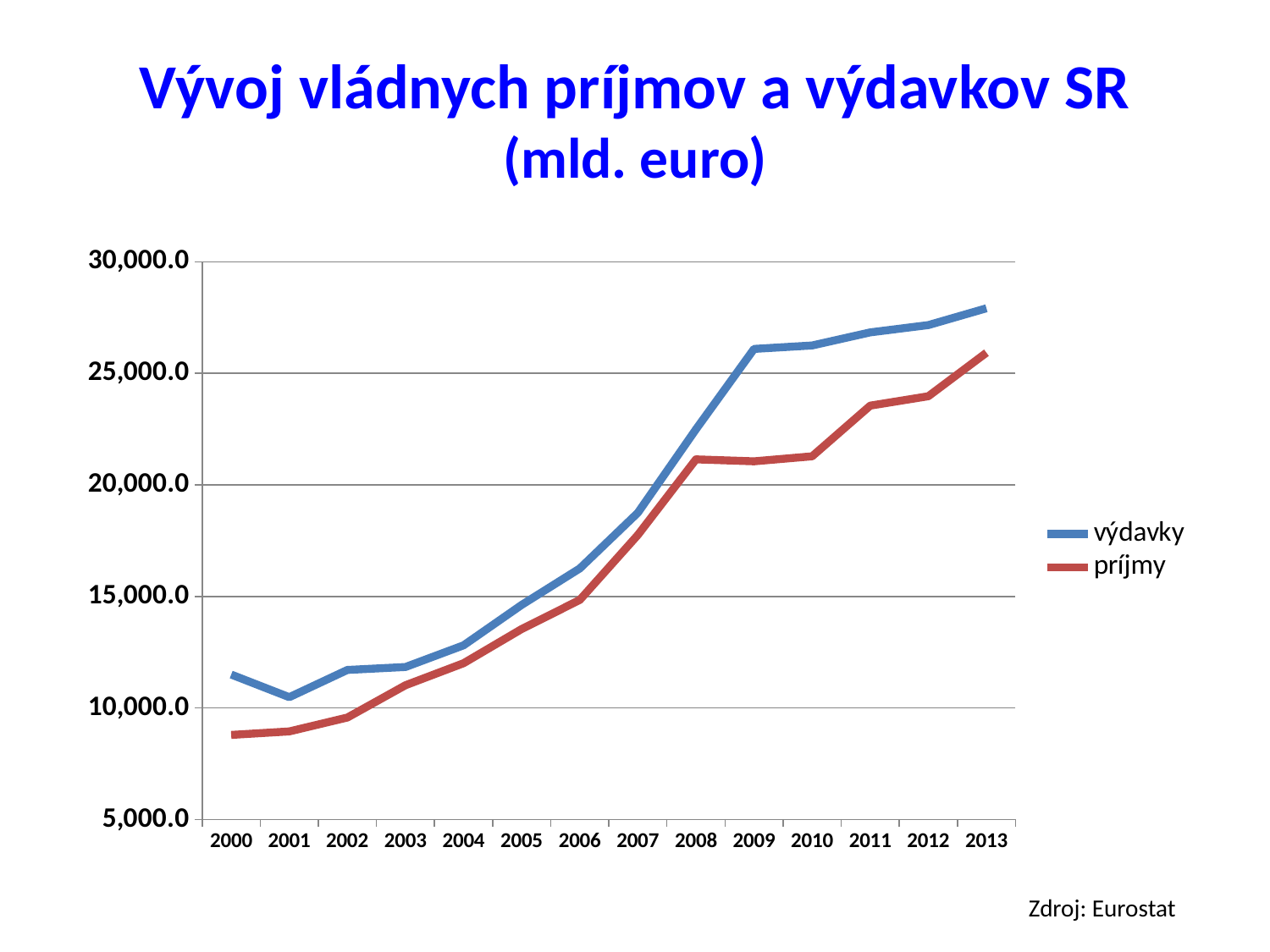
How many years are plotted along the x axis? 14 Is the value for výdavky in 2009 greater or less than 25,000.0? greater What kind of chart is shown on the slide? line chart How many series does the legend list? 2 In which year is the value for výdavky the lowest? 2001 In which year is the value for príjmy the lowest? 2000 Which series does the blue line represent? výdavky What is the title of the chart? Vývoj vládnych príjmov a výdavkov SR (mld. euro) In which year is the value for výdavky the highest? 2013 Do the values for príjmy generally rise or fall from 2000 to 2013? rise Is the value for príjmy in 2000 greater or less than 10,000.0? less In 2013, which is larger: výdavky or príjmy? výdavky